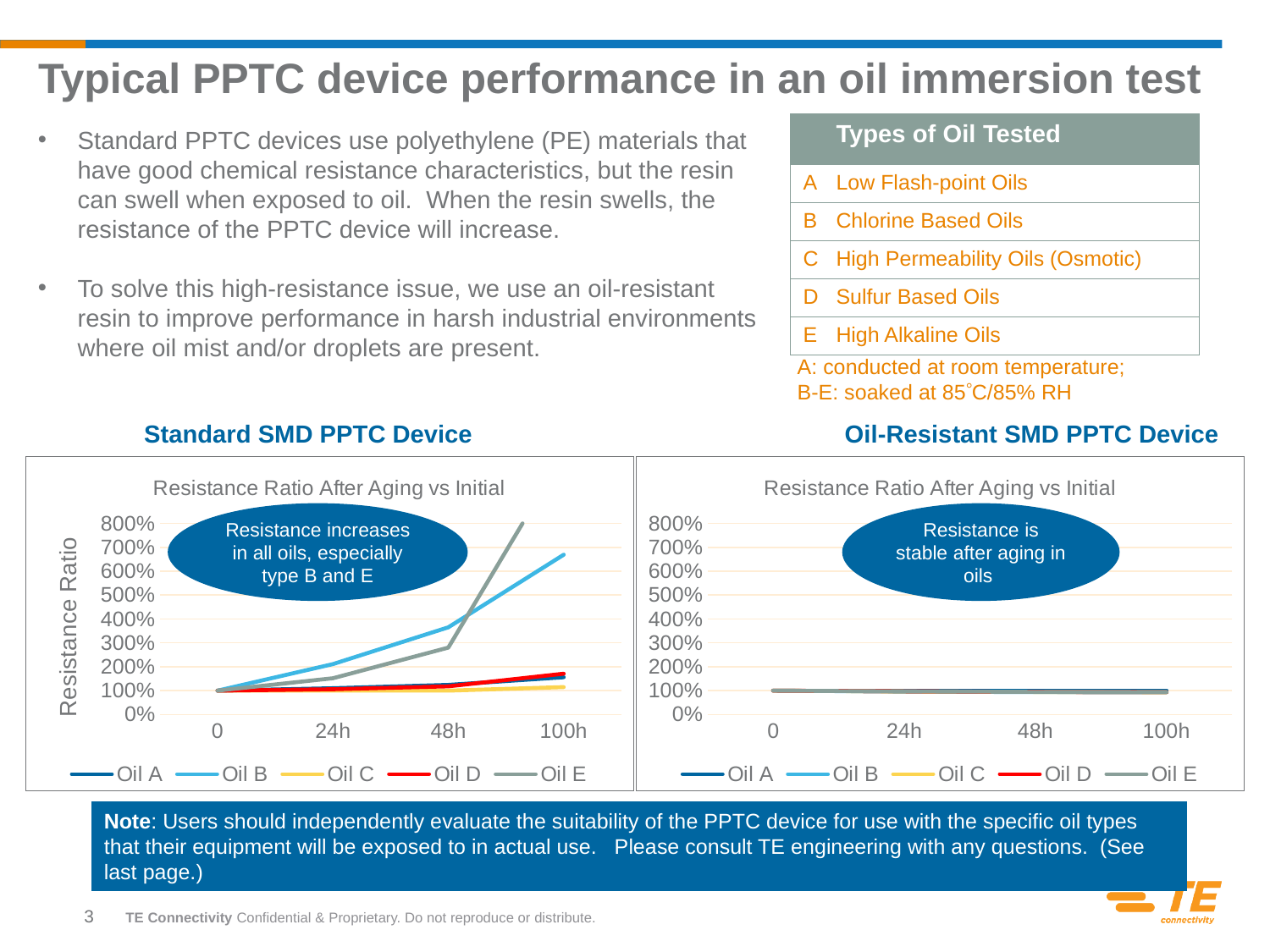
In the Oil-Resistant SMD PPTC Device chart, is the value for Oil B at 100h greater or less than 200%? less How many time points are shown on the x axis of the Oil-Resistant SMD PPTC Device chart? 4 How many series does the legend of the Standard SMD PPTC Device chart list? 5 What kind of chart is the Standard SMD PPTC Device chart on the left? line chart In the Standard SMD PPTC Device chart, which oil has the lowest resistance ratio at 100h? Oil C In the Standard SMD PPTC Device chart, is the value for Oil B at 100h greater or less than 500%? greater In the Standard SMD PPTC Device chart, which is larger at 48h, Oil B or Oil E? Oil B What is the title of the Oil-Resistant SMD PPTC Device chart on the right? Resistance Ratio After Aging vs Initial In the Standard SMD PPTC Device chart, is the value for Oil E at 48h greater or less than 400%? less In the Standard SMD PPTC Device chart, which oil has the highest resistance ratio at 100h? Oil E In the Standard SMD PPTC Device chart, does the resistance ratio for Oil E rise or fall from 0 to 100h? rise What does the annotation inside the Oil-Resistant SMD PPTC Device chart say? Resistance is stable after aging in oils